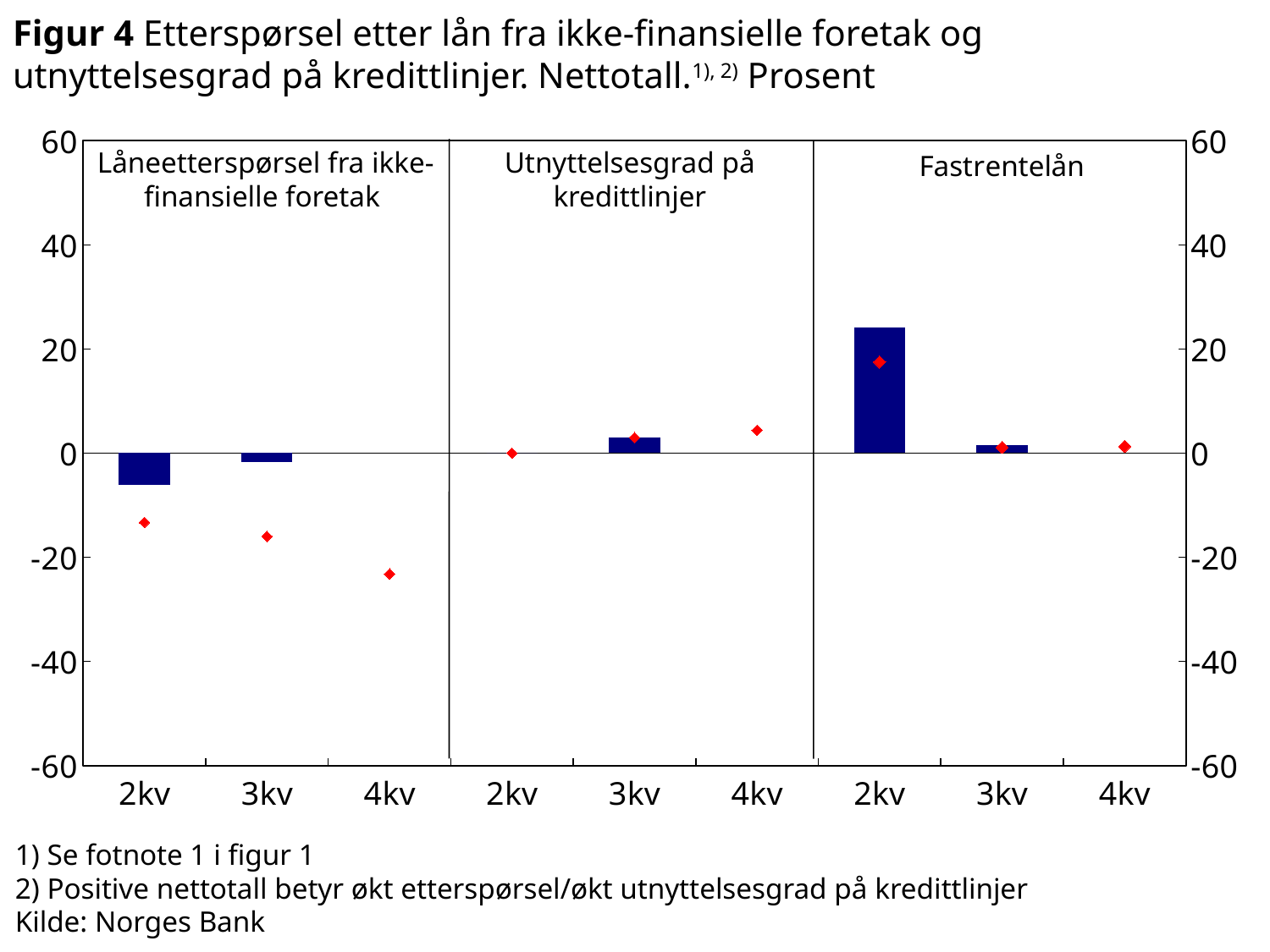
What is the title of the rightmost panel of the chart? Fastrentelån In the Låneetterspørsel fra ikke-finansielle foretak panel, is the bar for 2kv greater or less than 0? less In the Låneetterspørsel fra ikke-finansielle foretak panel, which quarter has the lowest red marker? 4kv In the Fastrentelån panel, which quarter has the highest bar? 2kv How many panels does the chart in Figur 4 have? 3 In the Utnyttelsesgrad på kredittlinjer panel, is the red marker for 4kv greater or less than 0? greater In the Fastrentelån panel, is the bar for 2kv greater or less than 20? greater In the Fastrentelån panel, which bar is larger, 2kv or 3kv? 2kv How many quarters are shown on the x axis of each panel? 3 What kind of chart is shown in Figur 4? bar chart with red diamond markers (combination bar and marker chart) In the Låneetterspørsel fra ikke-finansielle foretak panel, do the red markers rise or fall from 2kv to 4kv? fall